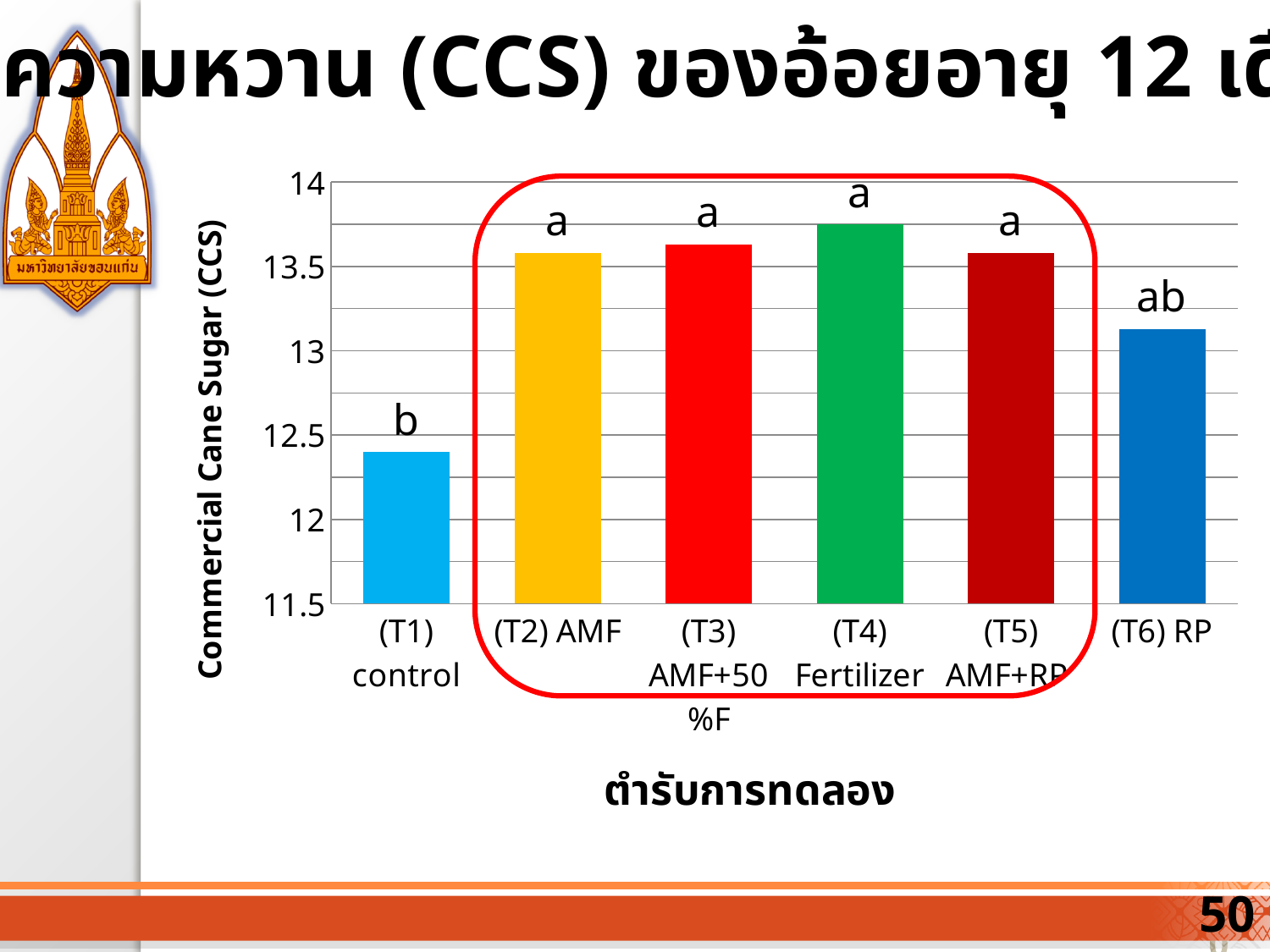
Is the value for (T1) control greater or less than 12.5? less Which treatment has the highest Commercial Cane Sugar (CCS) value? (T4) Fertilizer Which is larger, the value for (T4) Fertilizer or the value for (T6) RP? (T4) Fertilizer Is the value for (T2) AMF greater or less than 14? less What is the label on the vertical axis of the chart? Commercial Cane Sugar (CCS) Is the value for (T6) RP greater or less than 13? greater Which is larger, the value for (T1) control or the value for (T6) RP? (T6) RP Which treatment has the lowest Commercial Cane Sugar (CCS) value? (T1) control What kind of chart is shown on the slide? bar chart What letter is printed above the bar for (T1) control? b How many treatment categories are plotted on the x axis? 6